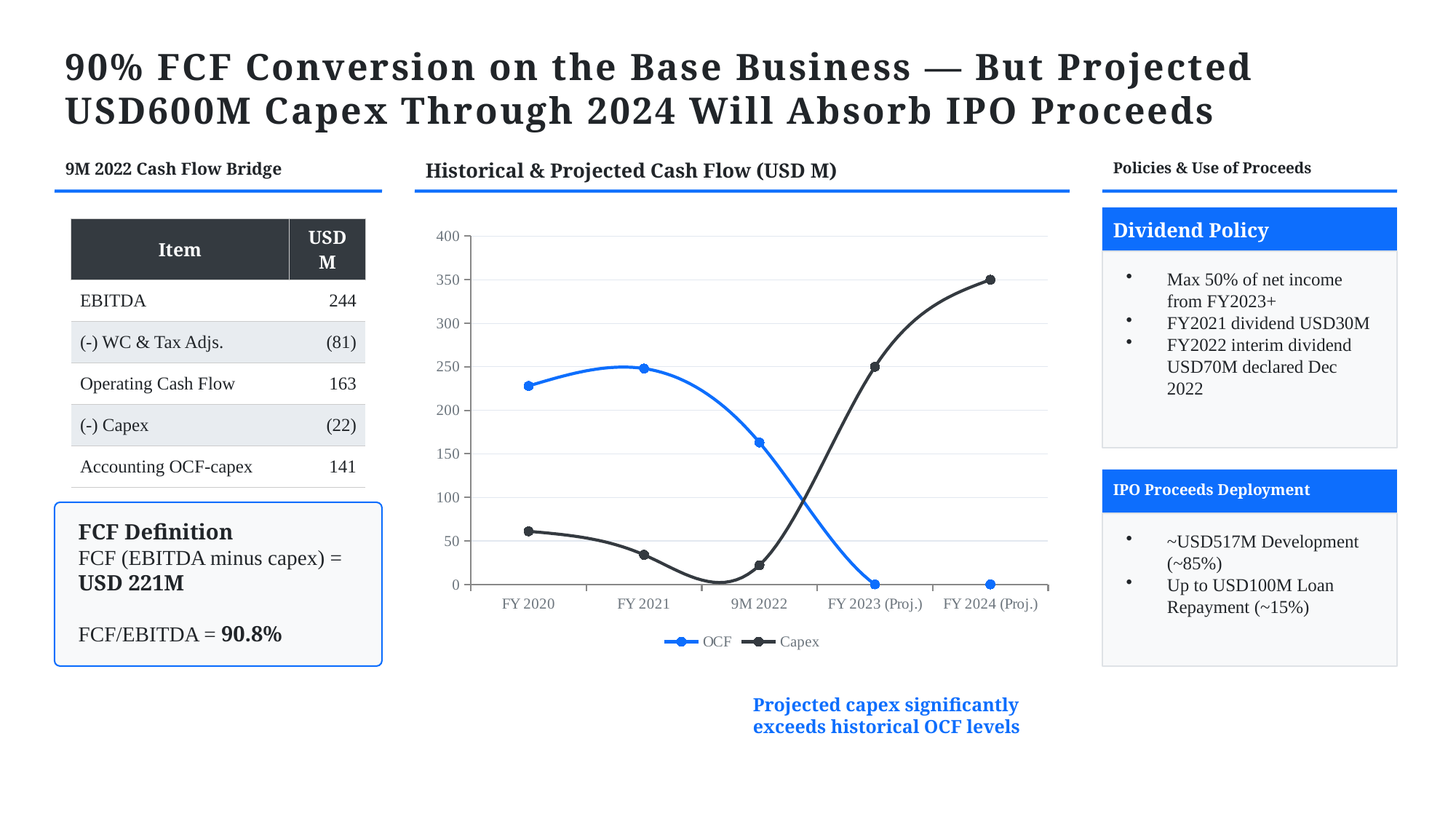
In the 'Historical & Projected Cash Flow (USD M)' chart, does the Capex line rise or fall from 9M 2022 to FY 2024 (Proj.)? rise In the 'Historical & Projected Cash Flow (USD M)' chart, is the OCF value for FY 2020 greater or less than 200? greater In the 'Historical & Projected Cash Flow (USD M)' chart, which is larger for 9M 2022: OCF or Capex? OCF How many periods are shown on the x axis of the 'Historical & Projected Cash Flow (USD M)' chart? 5 In the 'Historical & Projected Cash Flow (USD M)' chart, what is the Capex value for FY 2023 (Proj.)? 250 How many series does the legend of the 'Historical & Projected Cash Flow (USD M)' chart list? 2 In the 'Historical & Projected Cash Flow (USD M)' chart, what is the OCF value for FY 2024 (Proj.)? 0 In the 'Historical & Projected Cash Flow (USD M)' chart, what is the Capex value for FY 2024 (Proj.)? 350 What type of chart is shown under 'Historical & Projected Cash Flow (USD M)'? line chart In the 'Historical & Projected Cash Flow (USD M)' chart, which period has the highest Capex value? FY 2024 (Proj.) In the 'Historical & Projected Cash Flow (USD M)' chart, which period has the highest OCF value? FY 2021 In the 'Historical & Projected Cash Flow (USD M)' chart, is the Capex value for FY 2021 greater or less than 50? less